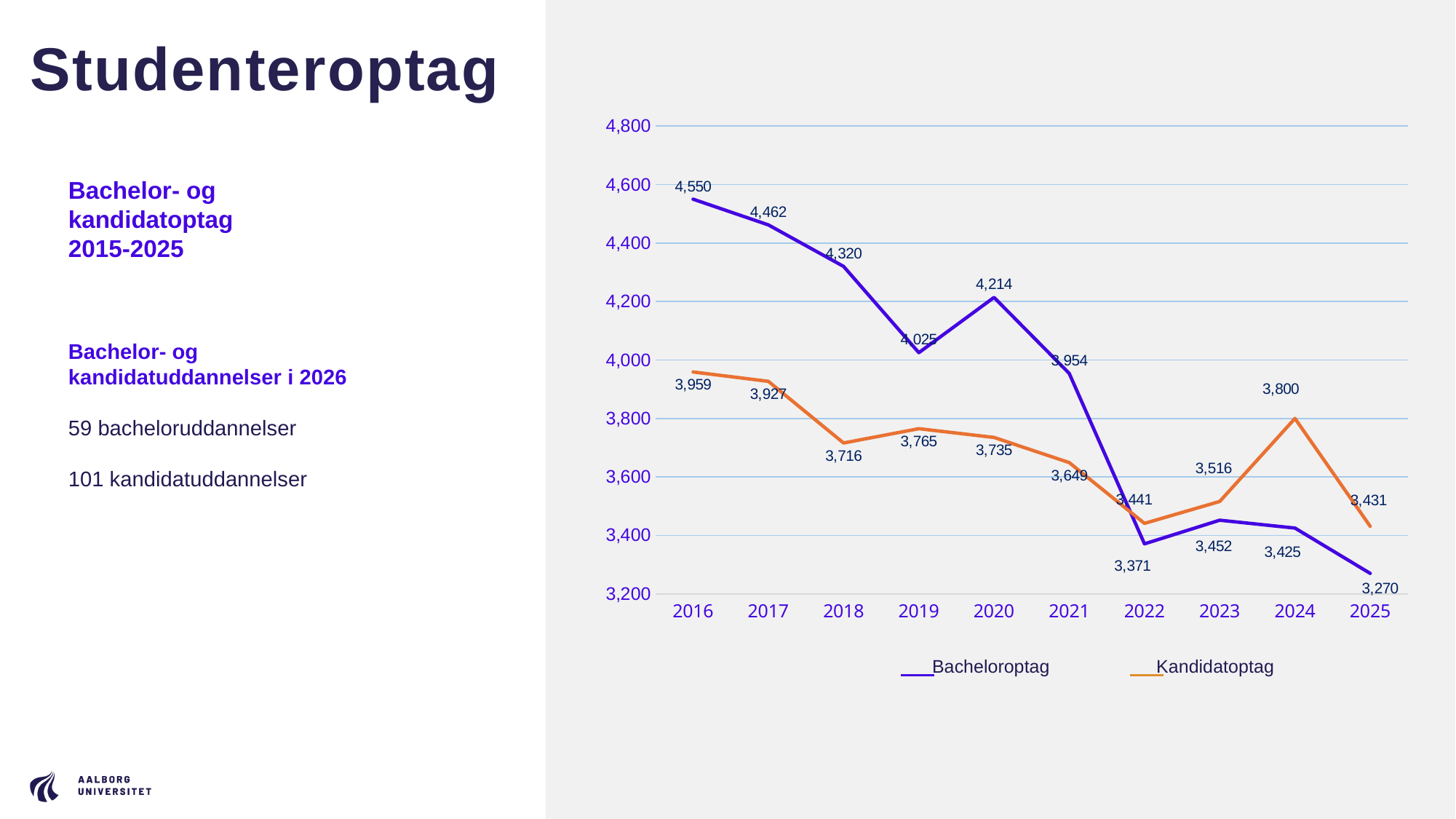
Does Bacheloroptag generally rise or fall from 2016 to 2025? fall What was the Bacheloroptag value in 2025? 3,270 What is the difference between Bacheloroptag in 2016 and in 2025? 1,280 In which year was Kandidatoptag at its highest? 2016 What kind of chart is shown on the slide? line chart Which colour is used for the Kandidatoptag line? orange In which year was Bacheloroptag at its lowest? 2025 Which was larger in 2024, Bacheloroptag or Kandidatoptag? Kandidatoptag How many years are shown on the x axis? 10 What was the Kandidatoptag value in 2024? 3,800 What was the Bacheloroptag value in 2016? 4,550 How many series does the legend list? 2